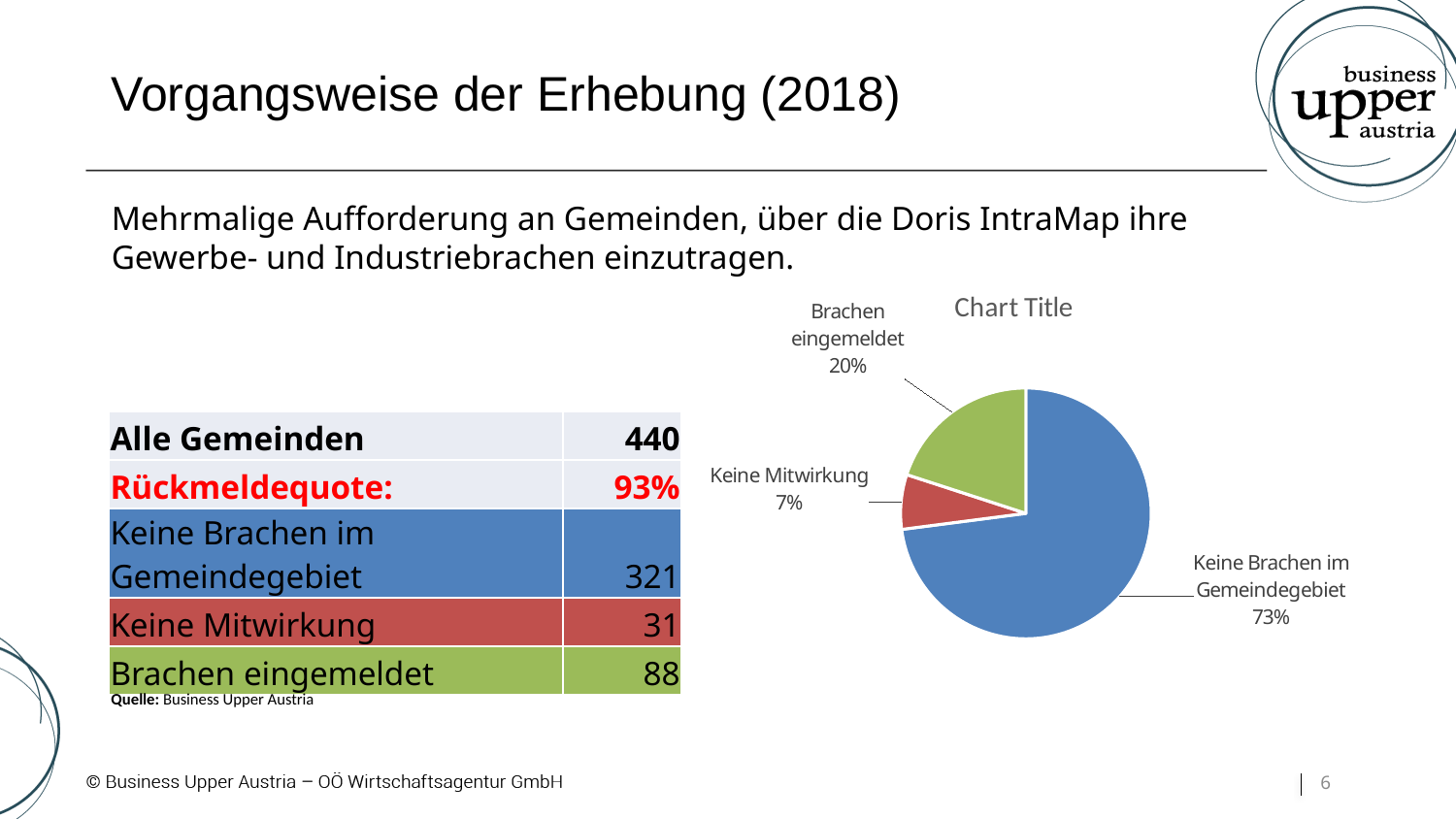
Which category has the largest slice in the pie chart? Keine Brachen im Gemeindegebiet What colour is the "Keine Mitwirkung" slice in the pie chart? red Which slice is larger in the pie chart: "Brachen eingemeldet" or "Keine Mitwirkung"? Brachen eingemeldet What is the difference in percentage points between "Keine Brachen im Gemeindegebiet" and "Brachen eingemeldet" in the pie chart? 53 What percentage is shown for "Brachen eingemeldet" in the pie chart? 20% Which category has the smallest slice in the pie chart? Keine Mitwirkung What type of chart is shown on the slide? pie chart What share of the pie chart does "Keine Brachen im Gemeindegebiet" represent? 73% What title is displayed above the pie chart? Chart Title What percentage is shown for "Keine Mitwirkung" in the pie chart? 7% What is the difference in percentage points between "Brachen eingemeldet" and "Keine Mitwirkung" in the pie chart? 13 How many slices does the pie chart have? 3